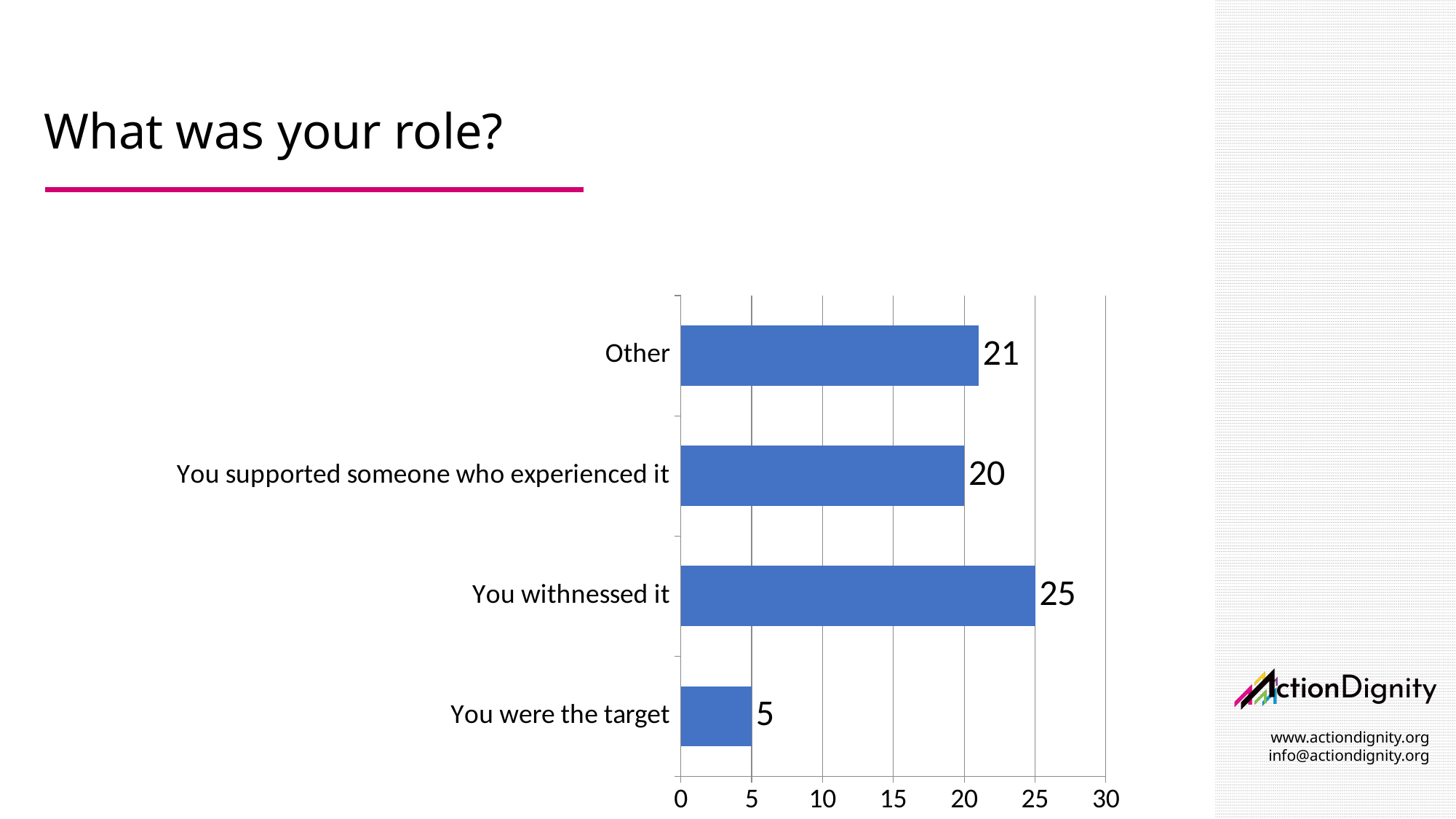
What is the difference between the values for "Other" and "You supported someone who experienced it"? 1 Which category has the lowest value? You were the target What is the title of the slide containing the chart? What was your role? What is the value for "You were the target"? 5 What is the value for "Other"? 21 What is the value for "You withnessed it"? 25 Which is larger, the value for "You withnessed it" or the value for "Other"? You withnessed it What kind of chart is shown on the slide? Bar chart Which category has the highest value? You withnessed it What is the difference between the values for "You withnessed it" and "You were the target"? 20 How many categories are shown in the chart? 4 What is the value for "You supported someone who experienced it"? 20